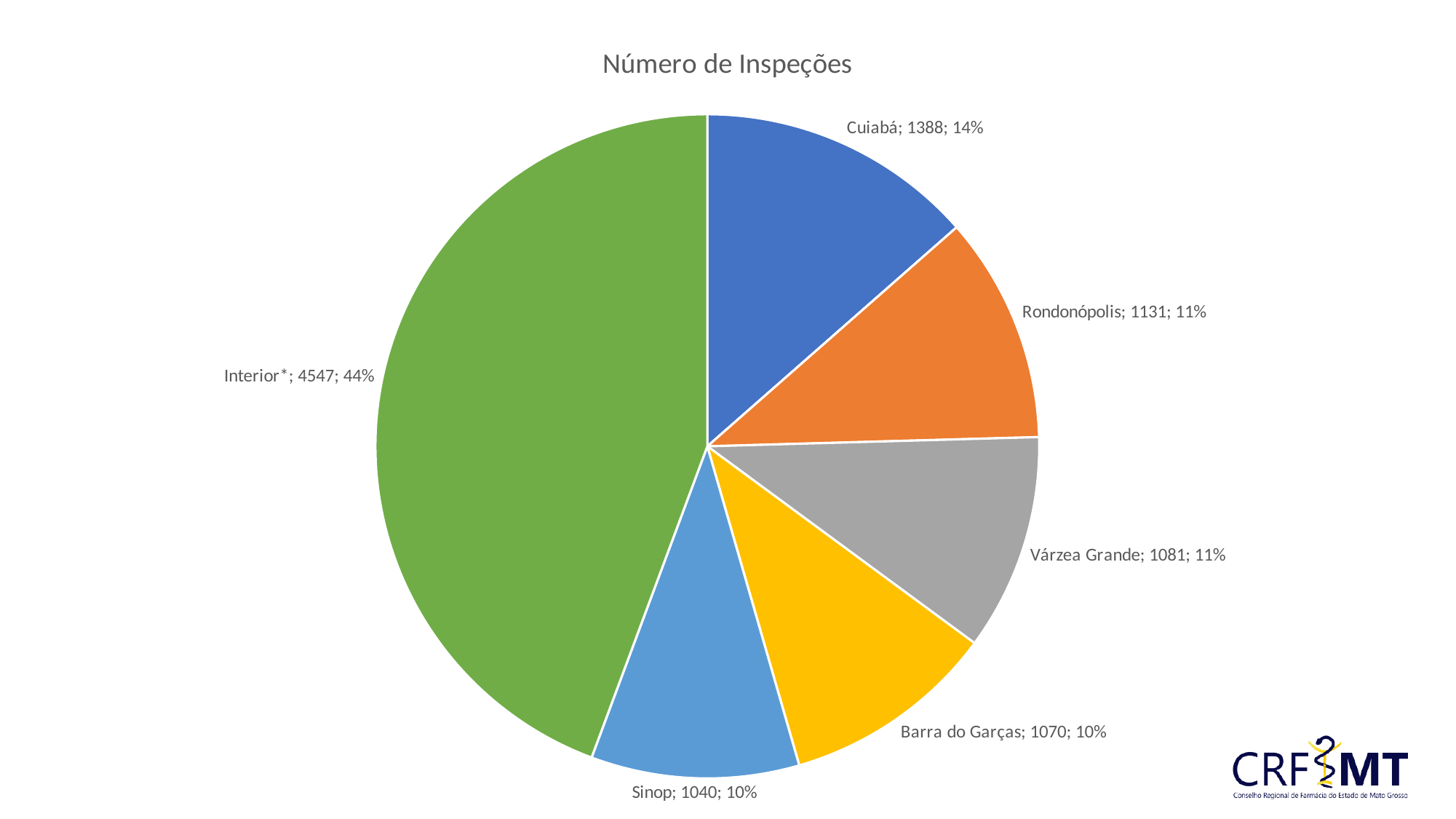
Which category has the largest slice? Interior* What share of the pie does Interior* represent? 44% Which has more inspections, Rondonópolis or Várzea Grande? Rondonópolis What type of chart is shown on the slide? pie chart What is the title of the chart? Número de Inspeções What is the number of inspections for Rondonópolis? 1131 What is the difference between the number of inspections for Cuiabá and Várzea Grande? 307 Which category has the smallest number of inspections? Sinop How many slices does the pie chart have? 6 What share of the pie does Barra do Garças represent? 10% What is the number of inspections for Cuiabá? 1388 What is the number of inspections for Sinop? 1040